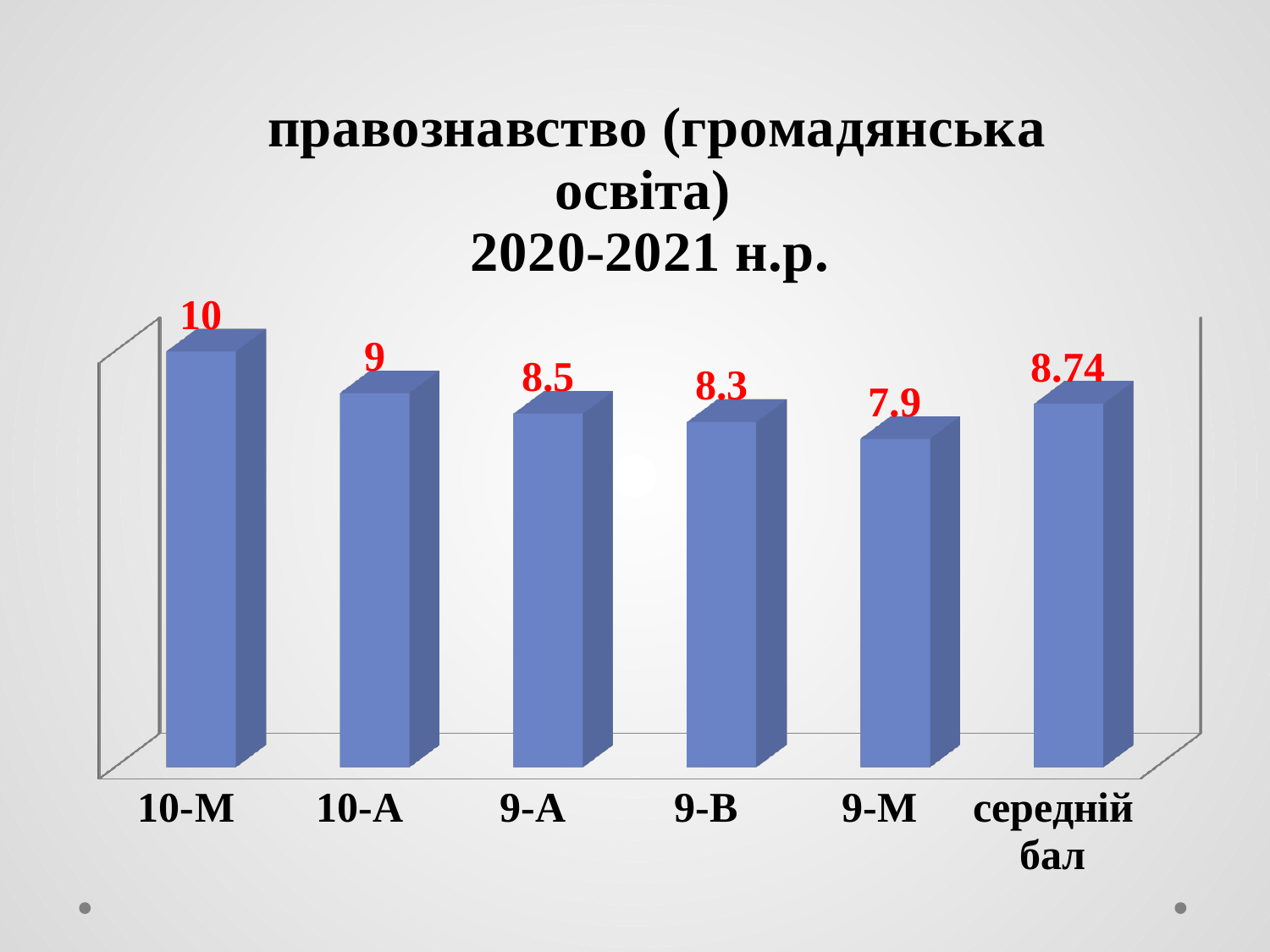
What is the difference between the values for 10-А and 9-А? 0.5 What school year is given in the chart title? 2020-2021 н.р. Which category has the highest value? 10-М What is the value shown for середній бал? 8.74 What kind of chart is shown on the slide? bar chart How many bars are shown in the chart? 6 What is the difference between the values for 10-М and 9-М? 2.1 Which is larger, the value for 9-А or the value for 9-В? 9-А Which category has the lowest value? 9-М What is the value for 9-В? 8.3 What is the value for 10-М? 10 Do the values rise or fall from 10-М to 9-М along the x axis? fall